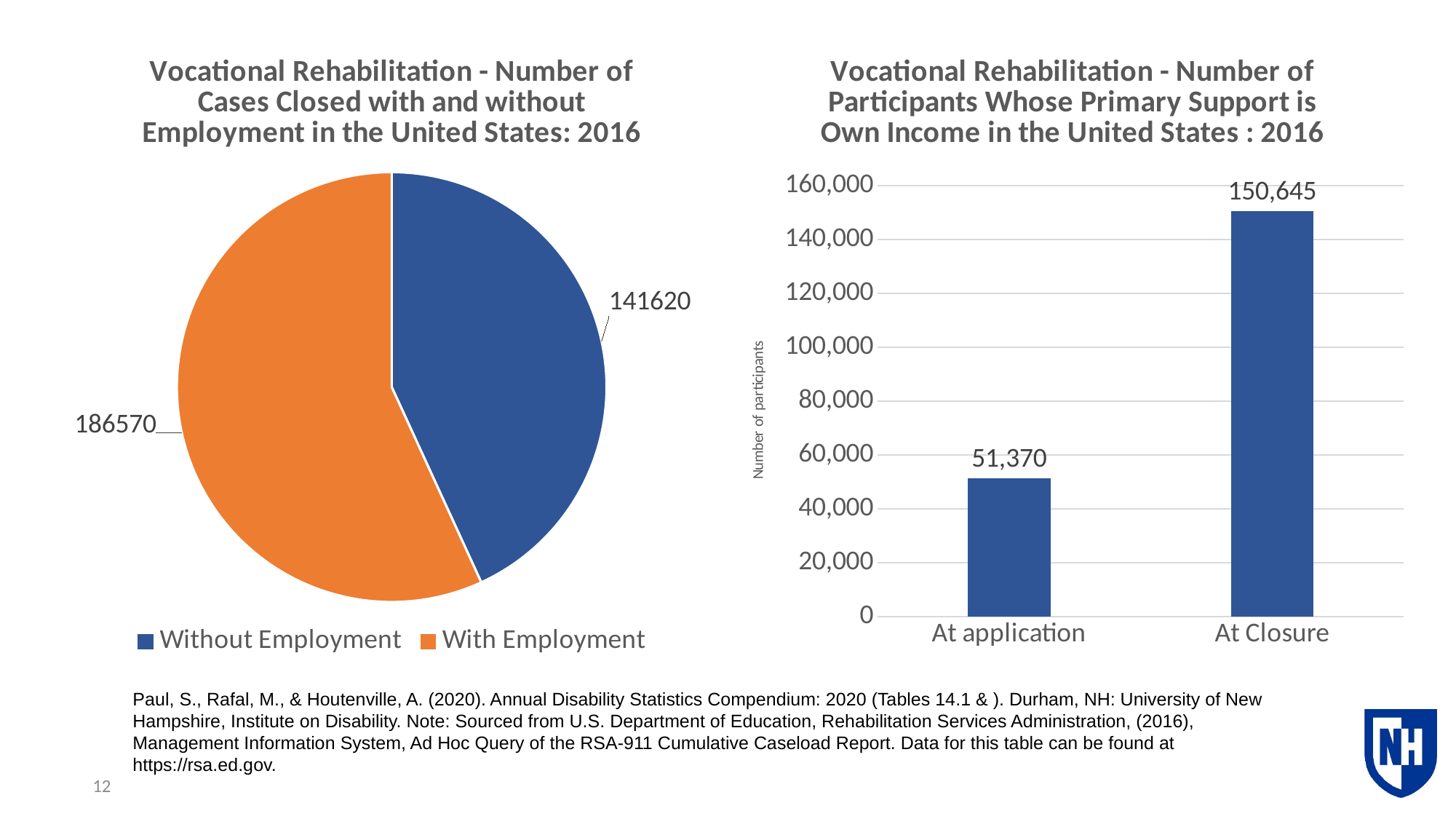
In the pie chart on the left, which colour represents Without Employment? Blue In the bar chart on the right, what is the difference between the At Closure and At application values? 99,275 What type of chart is the chart on the right of the slide? Bar chart In the bar chart on the right, what is the number of participants At application? 51,370 In the bar chart on the right, which category has the lower value? At application In the bar chart on the right, what is the number of participants At Closure? 150,645 In the pie chart on the left, what is the difference between the With Employment and Without Employment values? 44950 In the pie chart on the left, how many cases were closed Without Employment? 141620 In the bar chart on the right, how many categories are shown on the x axis? 2 In the pie chart on the left, which category has the larger slice? With Employment In the pie chart on the left, what is the total number of cases closed across both categories? 328190 In the pie chart on the left, how many cases were closed With Employment? 186570